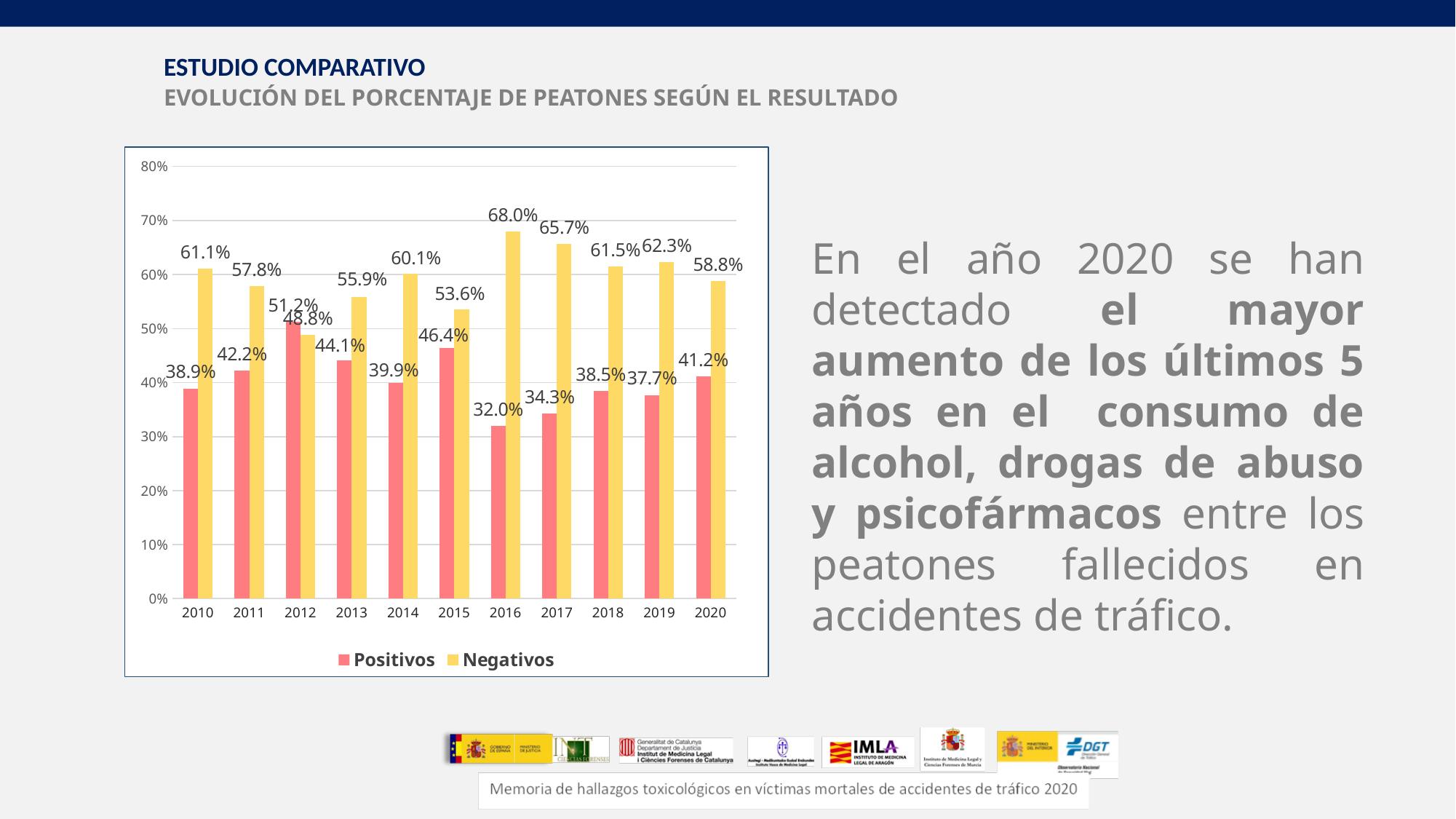
In which year is the Negativos percentage lowest? 2012 Do the Positivos values rise or fall from 2016 to 2020? Rise What is the Positivos value for 2020? 41.2% In 2012, which is larger, Positivos or Negativos? Positivos What is the difference between the Negativos and Positivos values in 2020? 17.6 percentage points How many years are shown on the x axis? 11 In which year is the Positivos percentage highest? 2012 What kind of chart is shown on the slide? Bar chart In which year is the Positivos percentage lowest? 2016 What is the Negativos value for 2016? 68.0% How many series does the legend list? 2 What colour represents the Negativos series? Yellow